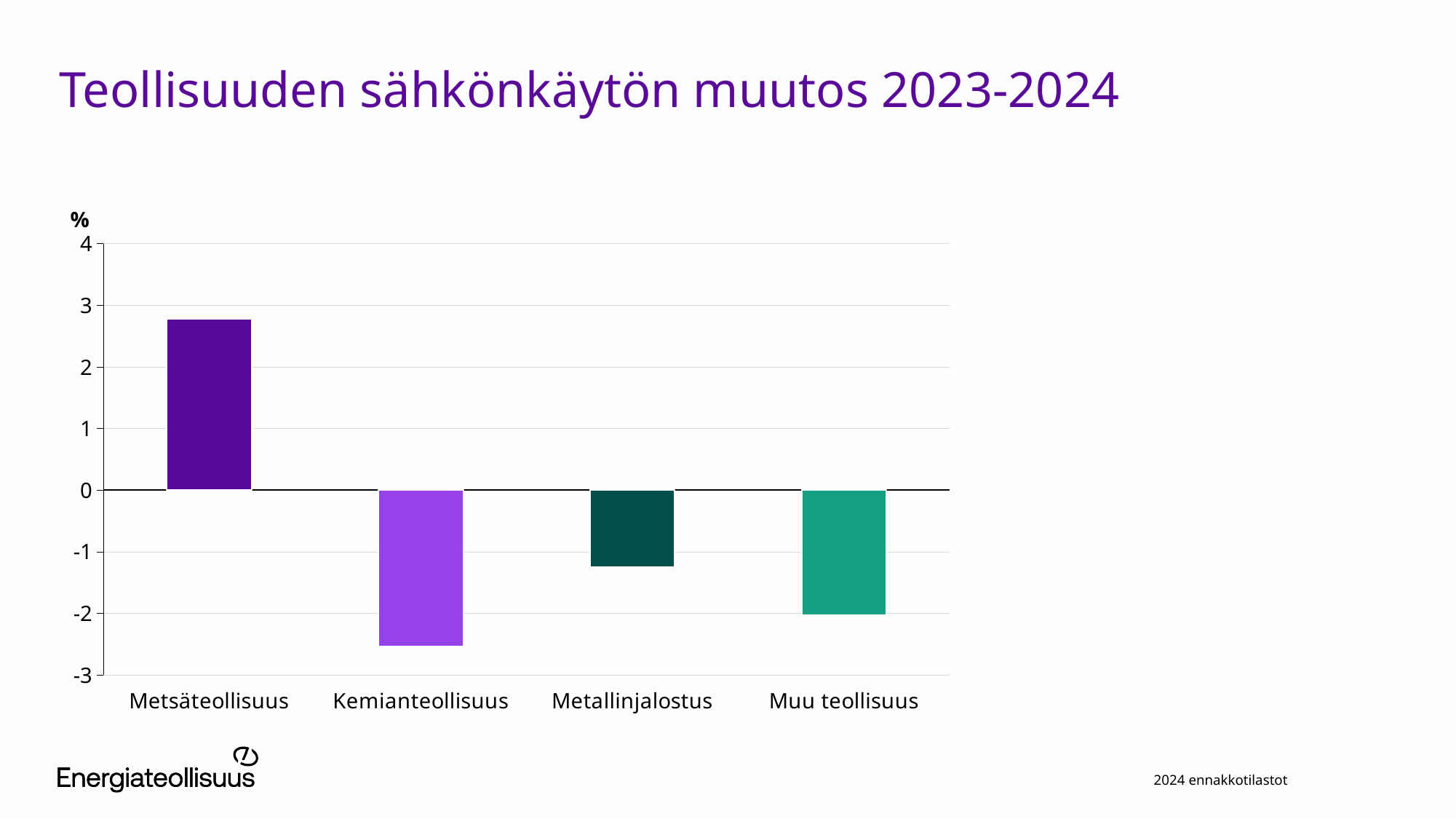
Is the value for Metsäteollisuus greater or less than 3? less Is the value for Kemianteollisuus greater or less than -2? less What kind of chart is shown on the slide? bar chart Which category has the lowest value in the chart? Kemianteollisuus Which category has the highest value in the chart? Metsäteollisuus Is the value for Metallinjalostus greater or less than -2? greater What is the title of the chart on the slide? Teollisuuden sähkönkäytön muutos 2023-2024 Which has the larger value, Metallinjalostus or Muu teollisuus? Metallinjalostus Which has the larger value, Metsäteollisuus or Kemianteollisuus? Metsäteollisuus How many categories in the chart have a negative value? 3 How many categories are shown on the x axis of the chart? 4